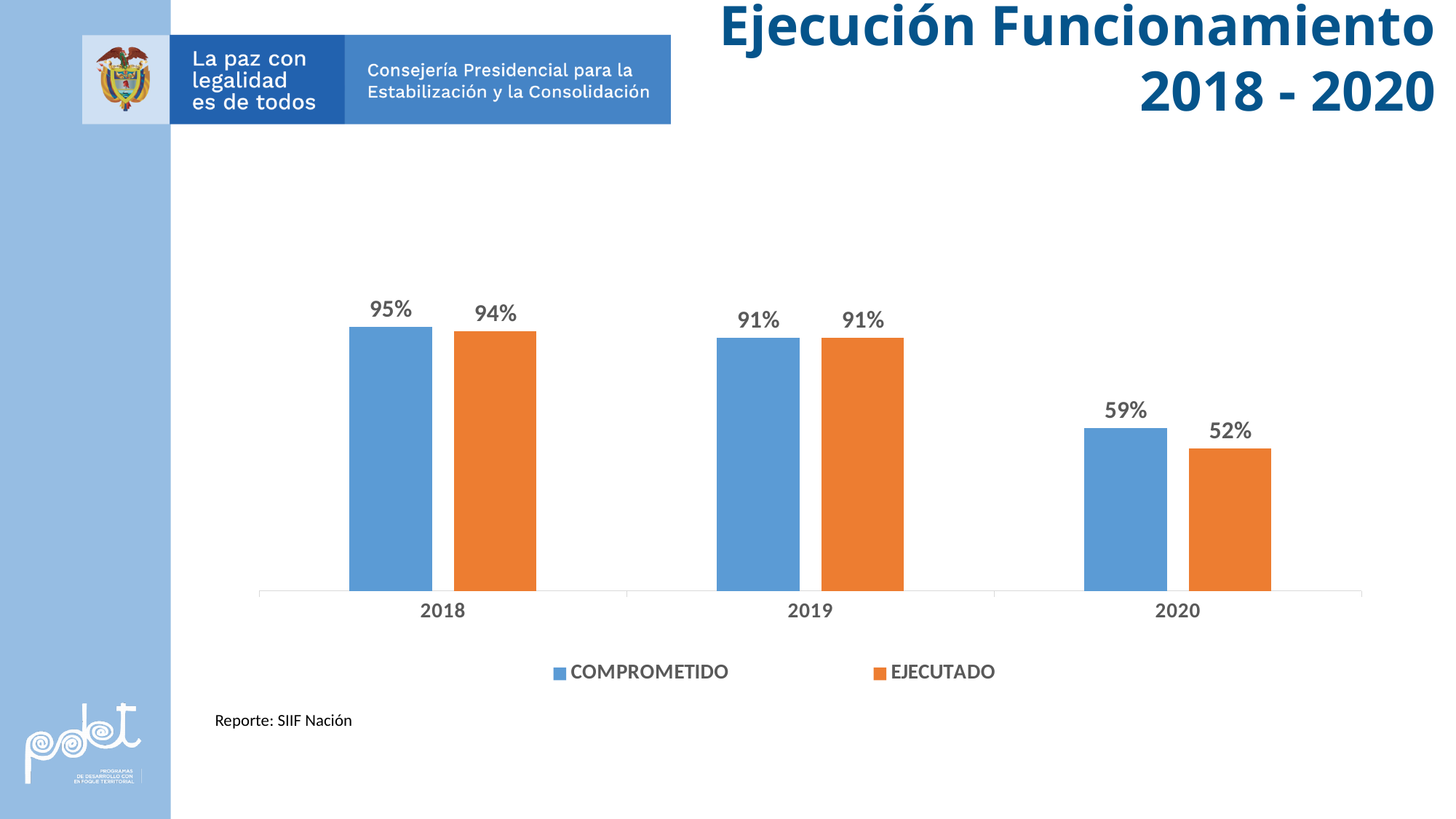
What is the COMPROMETIDO value for 2018? 95% Do the COMPROMETIDO values rise or fall from 2018 to 2020? Fall How many years are shown on the x axis? 3 What is the EJECUTADO value for 2020? 52% What is the difference between the COMPROMETIDO and EJECUTADO values for 2020? 7% Which year has the highest COMPROMETIDO value? 2018 What kind of chart is shown on the slide? Bar chart Which is larger, the EJECUTADO value for 2018 or the EJECUTADO value for 2020? 2018 What is the difference between the COMPROMETIDO values for 2018 and 2020? 36% Which year has the lowest EJECUTADO value? 2020 How many series does the legend list? 2 What is the EJECUTADO value for 2019? 91%